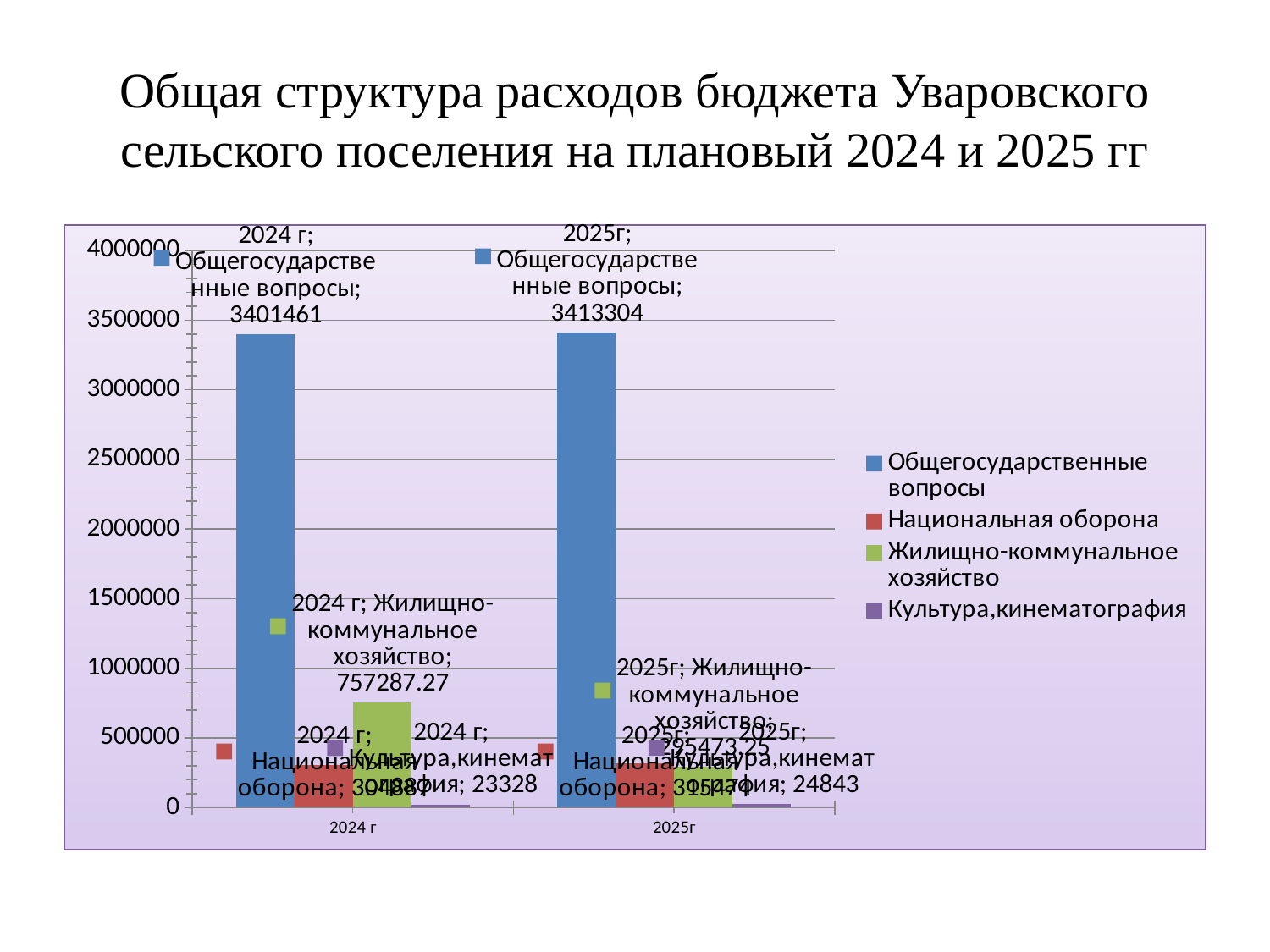
What is the value for Общегосударственные вопросы in 2025г? 3413304 What is the value for Жилищно-коммунальное хозяйство in 2024 г? 757287.27 Is the value for Жилищно-коммунальное хозяйство in 2025г greater or less than 500000? less By how much does Общегосударственные вопросы in 2025г exceed its value in 2024 г? 11843 What is the value for Культура,кинематография in 2024 г? 23328 What kind of chart is shown on the slide? bar chart Which series has the lowest value in 2025г? Культура,кинематография How many series does the legend list? 4 Which series has the highest value in 2024 г? Общегосударственные вопросы What is the difference between Культура,кинематография in 2025г and in 2024 г? 1515 What is the value for Общегосударственные вопросы in 2024 г? 3401461 What is the value for Культура,кинематография in 2025г? 24843